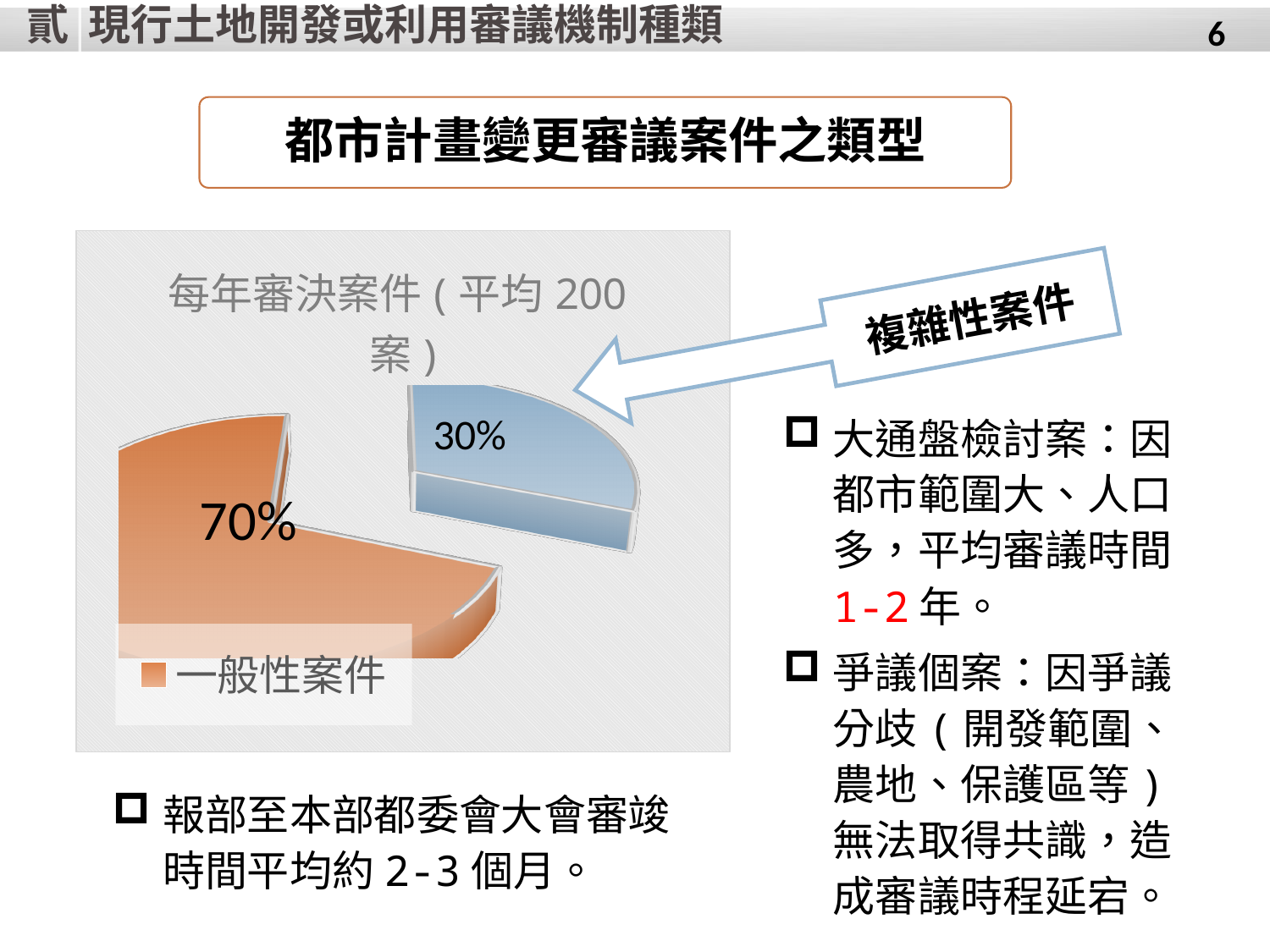
What share of the pie does 一般性案件 take? 70% Which slice of the pie is the largest? 一般性案件 How many slices does the pie chart have? 2 What is the difference in percentage points between the 一般性案件 slice and the 複雜性案件 slice? 40 What share of the pie does the slice marked 複雜性案件 take? 30% Which is larger, the 一般性案件 slice or the 複雜性案件 slice? 一般性案件 What colour is the 一般性案件 slice? orange What is the title of the pie chart? 每年審決案件（平均200案） What kind of chart is shown on the slide? pie chart Which slice of the pie is the smallest? 複雜性案件 What is the total of the two percentages shown on the pie chart? 100%